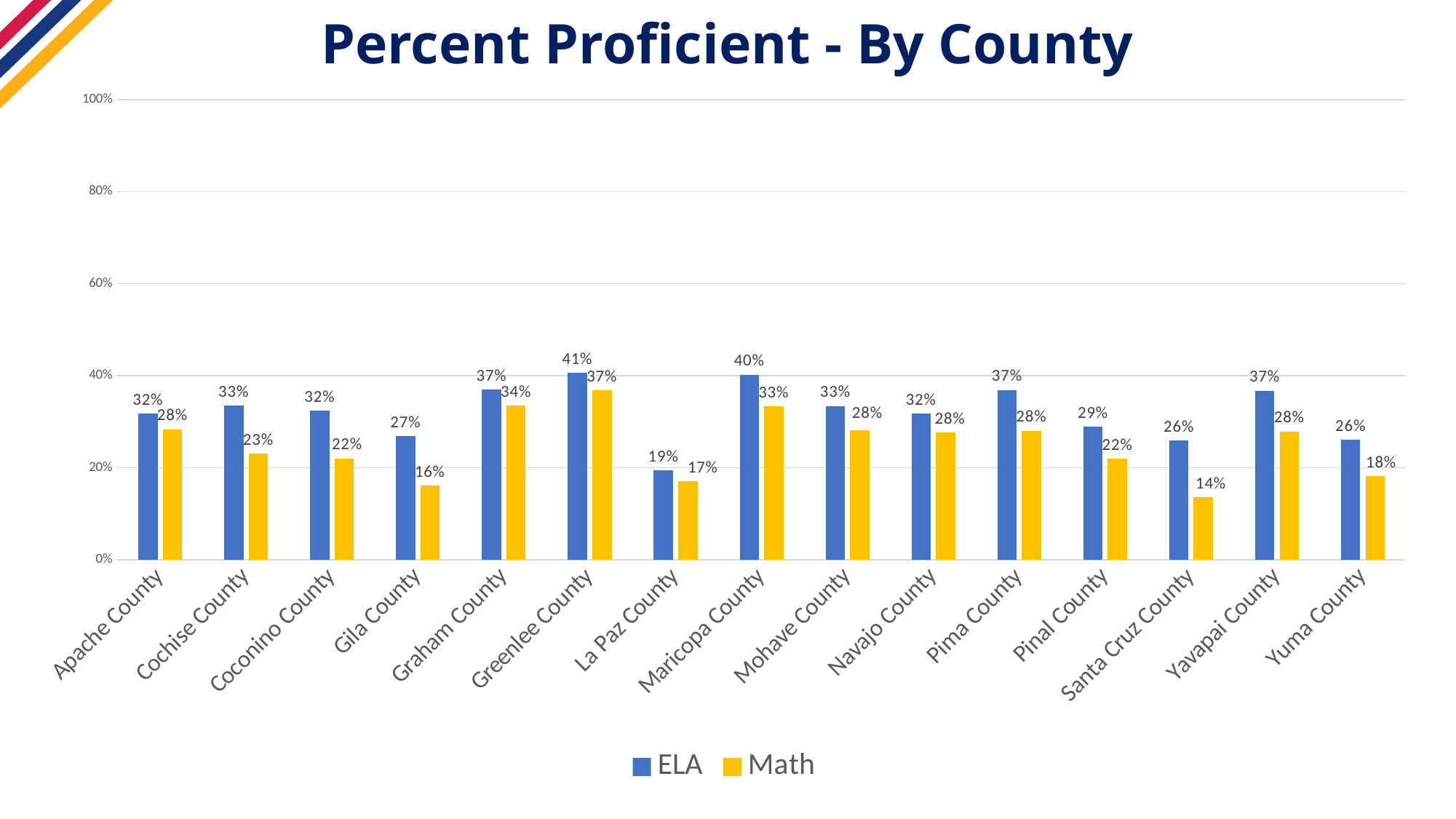
Which county has the lowest Math percent proficient? Santa Cruz County What is the title of the chart? Percent Proficient - By County What is the ELA percent proficient for Maricopa County? 40% What is the Math percent proficient for Santa Cruz County? 14% Which colour represents the Math series in the chart? yellow How many series does the legend list? 2 What is the difference between the ELA and Math percent proficient for Gila County? 11% Is the ELA value for La Paz County greater or less than 20%? less Which is larger, the Math value for Graham County or the Math value for Maricopa County? Graham County How many counties are shown on the x axis? 15 What kind of chart is shown on the slide? bar chart Which county has the highest ELA percent proficient? Greenlee County